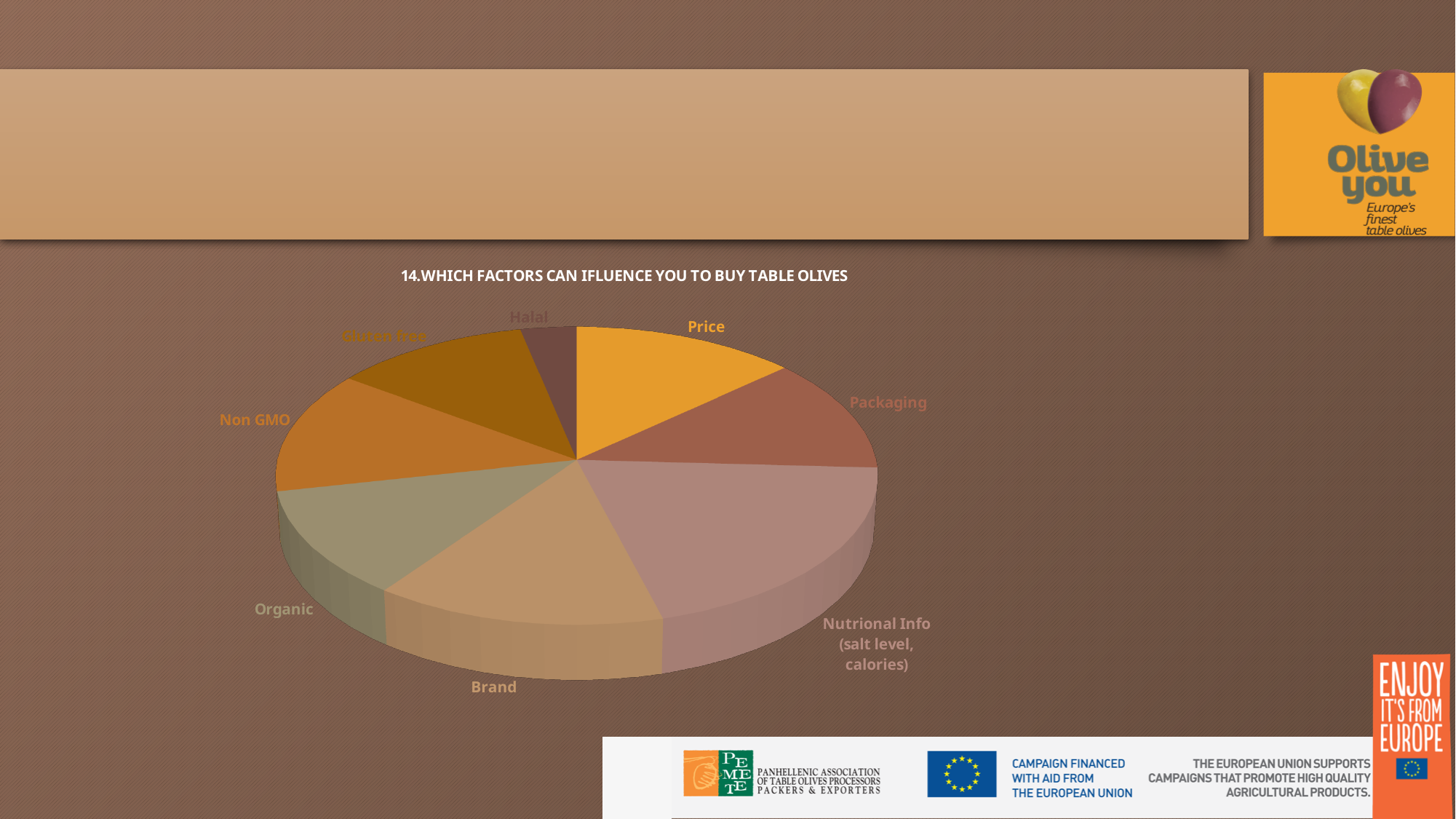
Which slice is larger, Brand or Packaging? Brand Which slice is larger, Halal or Organic? Organic Which factor has the largest slice in the pie chart? Nutrional Info (salt level, calories) Which slice of the pie chart is coloured bright yellow-orange? Price Which slice is larger, Price or Halal? Price What kind of chart is shown on the slide? pie chart How many slices does the pie chart have? 8 What is the title of the chart? 14.WHICH FACTORS CAN IFLUENCE YOU TO BUY TABLE OLIVES Which factor has the smallest slice in the pie chart? Halal